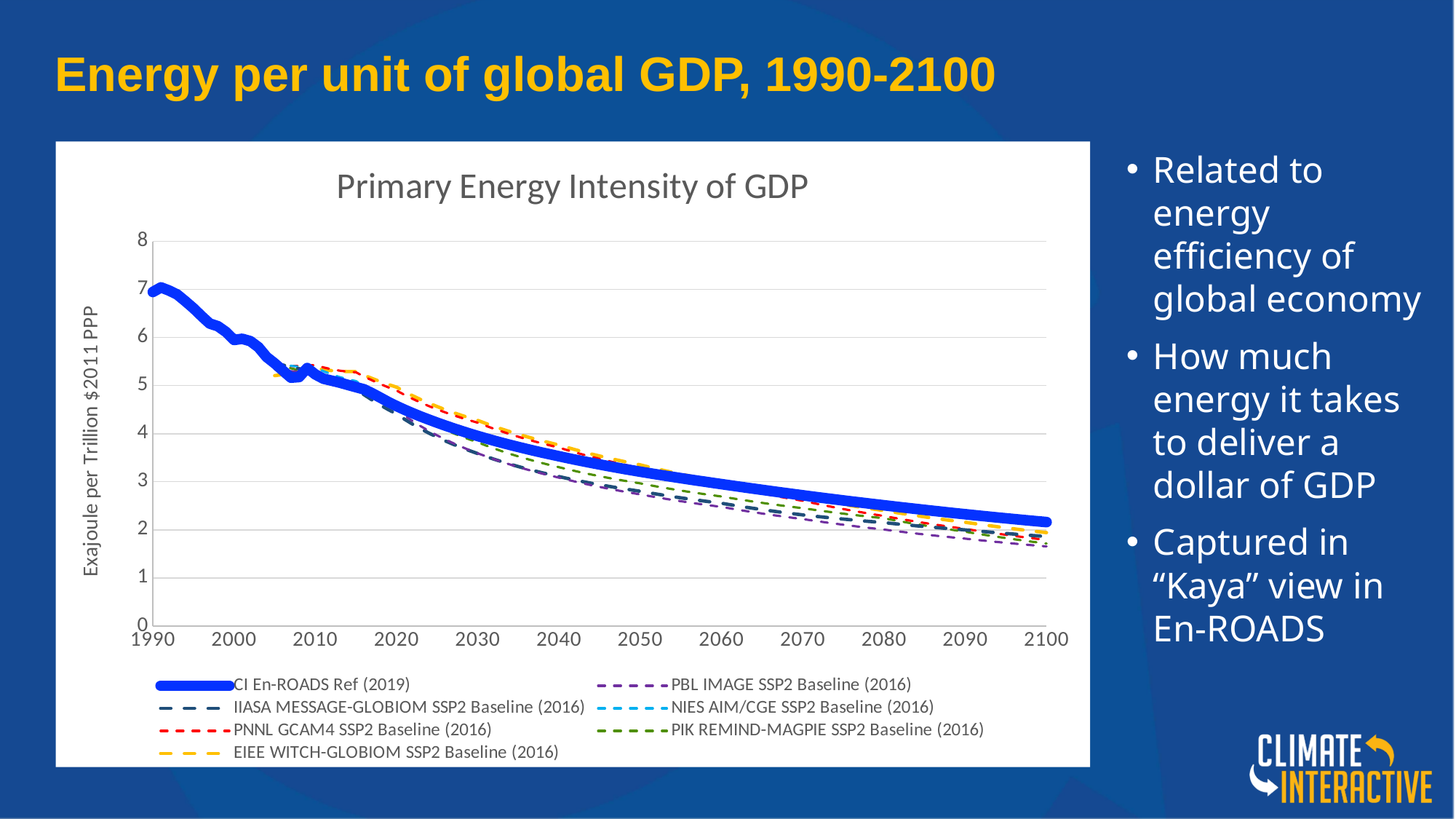
What kind of chart is shown on the slide? line chart How many year labels are shown on the x axis of the chart? 12 Do the values of the CI En-ROADS Ref (2019) series rise or fall from 1990 to 2100? fall In 2100, which is larger: the value for CI En-ROADS Ref (2019) or the value for PBL IMAGE SSP2 Baseline (2016)? CI En-ROADS Ref (2019) Is the value for CI En-ROADS Ref (2019) in 1990 greater or less than 6? greater Is the value for PBL IMAGE SSP2 Baseline (2016) in 2100 greater or less than 2? less What is the label on the y axis of the chart? Exajoule per Trillion $2011 PPP What is the title of the chart? Primary Energy Intensity of GDP Is the value for CI En-ROADS Ref (2019) in 2100 greater or less than 3? less How many series does the legend of the chart list? 7 Which series has the highest value in 2100? CI En-ROADS Ref (2019)